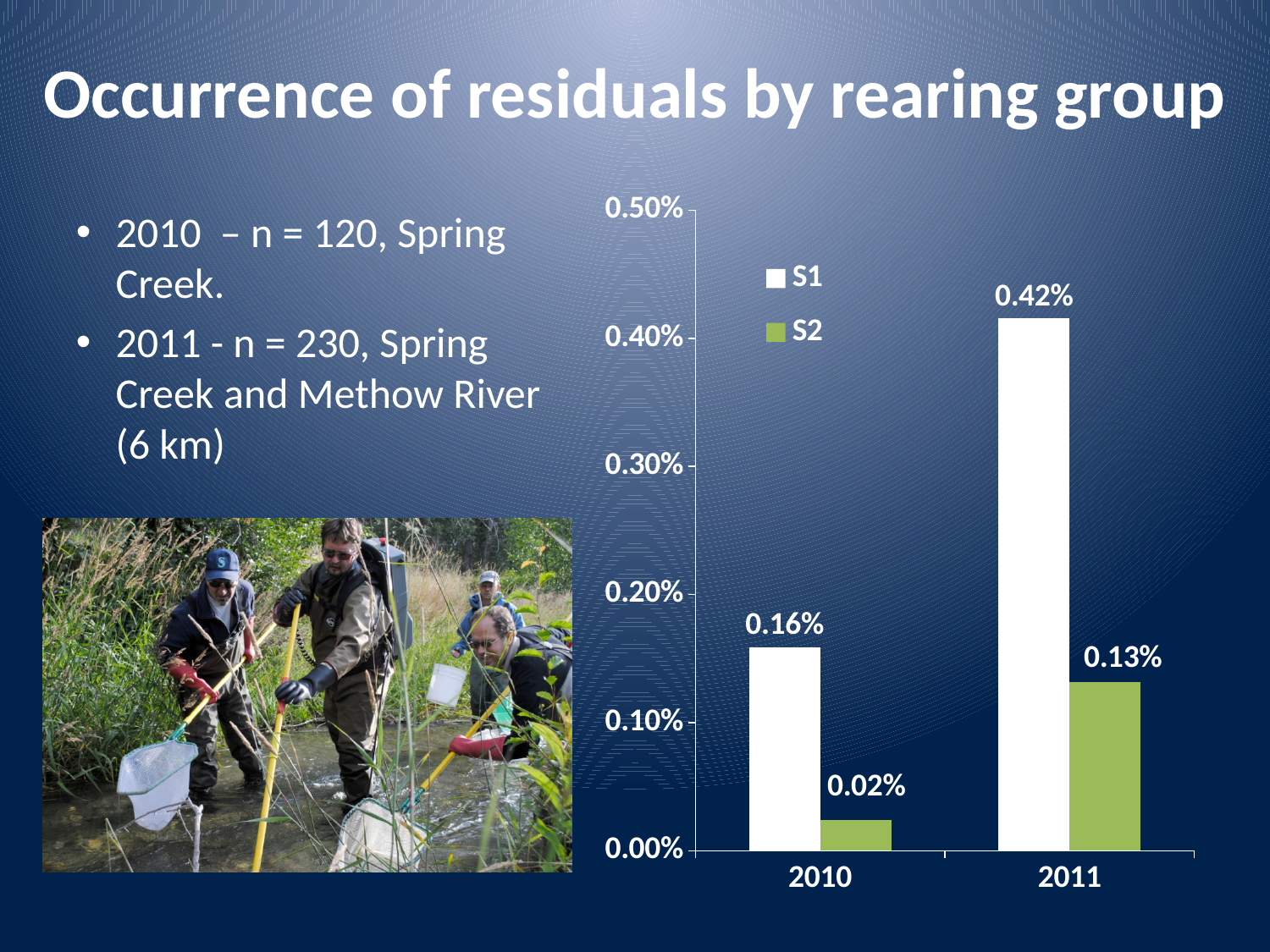
What is the value for S1 in 2011? 0.42% What is the value for S2 in 2011? 0.13% What is the value for S2 in 2010? 0.02% What is the value for S1 in 2010? 0.16% Which series has the lowest value in 2010? S2 Which year has the highest S1 value? 2011 Does the S2 value rise or fall from 2010 to 2011? Rise What kind of chart is shown on the slide? Bar chart What is the difference between the S1 values for 2011 and 2010? 0.26% Which is larger, the S2 value in 2011 or the S1 value in 2010? S1 value in 2010 How many years are shown on the x axis? 2 How many series does the legend list? 2